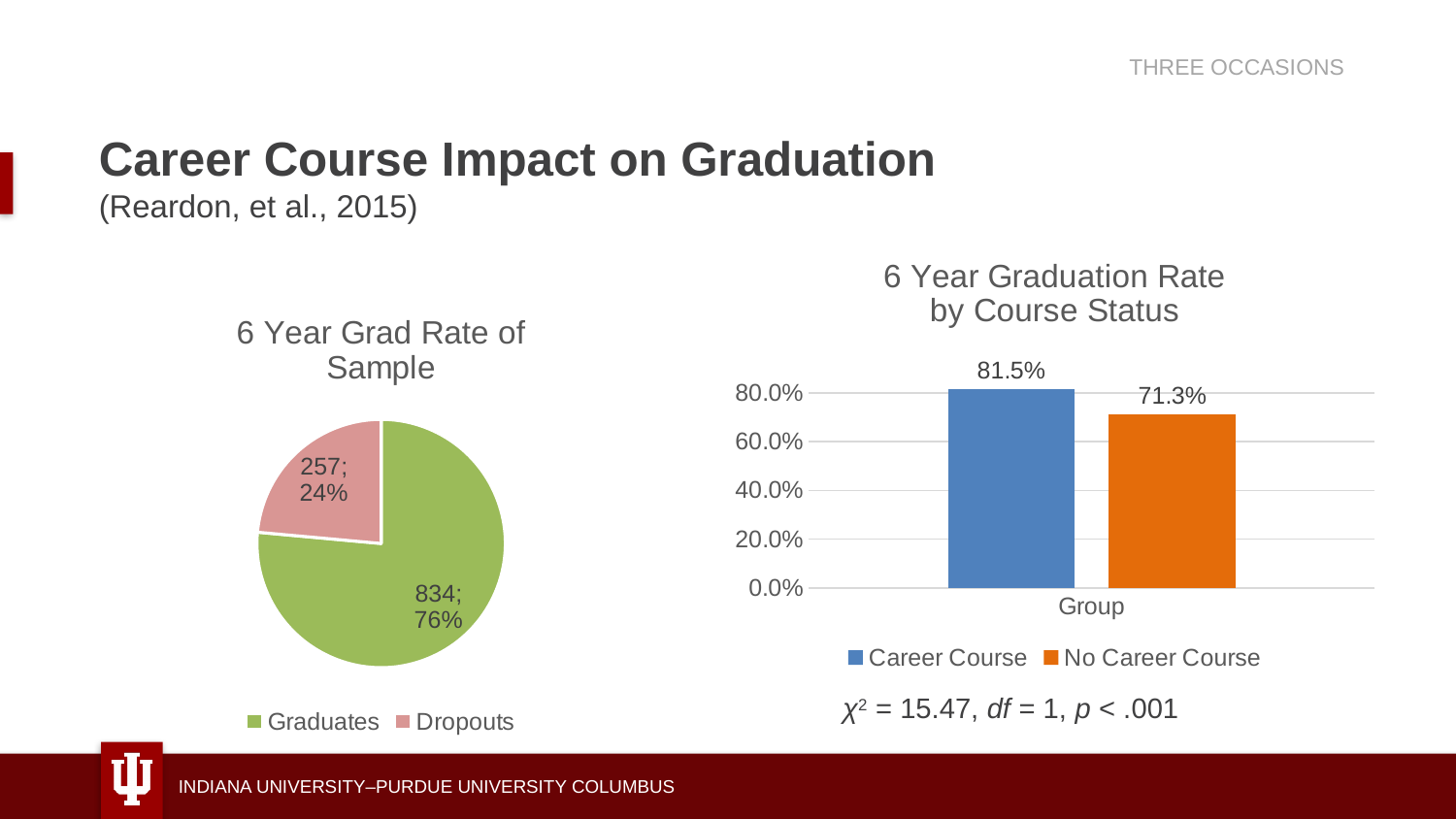
In the '6 Year Graduation Rate by Course Status' chart, which group has the higher graduation rate? Career Course In the '6 Year Graduation Rate by Course Status' chart, what is the graduation rate for the No Career Course group? 71.3% In the '6 Year Grad Rate of Sample' chart, which slice is larger, Graduates or Dropouts? Graduates In the '6 Year Grad Rate of Sample' chart, what is the difference between the number of Graduates and the number of Dropouts? 577 In the '6 Year Graduation Rate by Course Status' chart, what is the graduation rate for the Career Course group? 81.5% In the '6 Year Grad Rate of Sample' chart, what kind of chart is shown? pie chart In the '6 Year Graduation Rate by Course Status' chart, what is the difference in graduation rate between the Career Course and No Career Course groups? 10.2% In the '6 Year Graduation Rate by Course Status' chart, how many series does the legend list? 2 In the '6 Year Grad Rate of Sample' chart, how many slices does the pie have? 2 In the '6 Year Grad Rate of Sample' chart, what share of the pie do Dropouts represent? 24% In the '6 Year Graduation Rate by Course Status' chart, what kind of chart is shown? bar chart In the '6 Year Grad Rate of Sample' chart, how many graduates are in the sample? 834